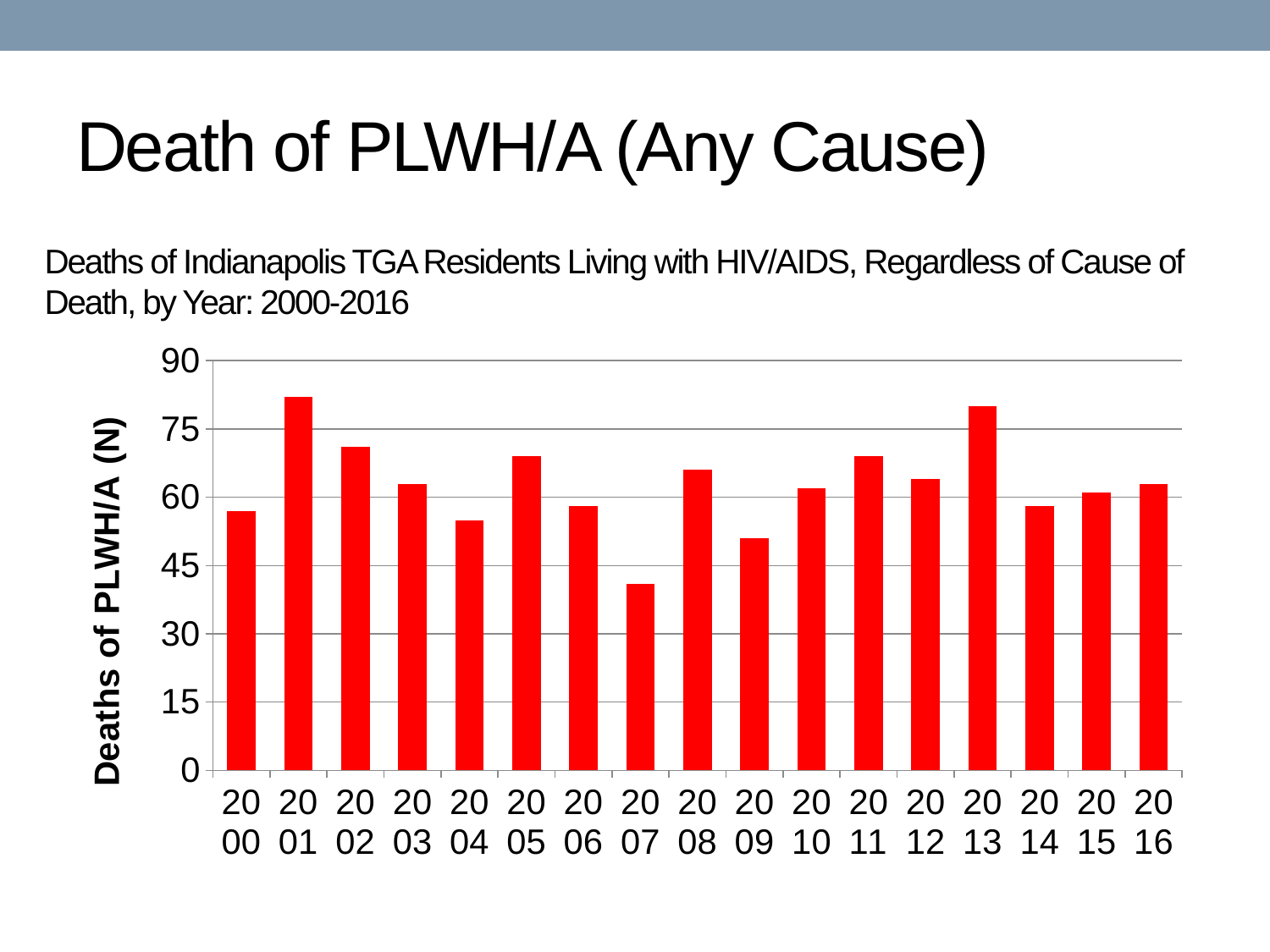
Is the value for 2002 greater or less than 60? greater Is the value for 2013 greater or less than 75? greater What kind of chart is shown on the slide? bar chart Which year has the lowest number of deaths of PLWH/A? 2007 Which year has the larger value, 2001 or 2007? 2001 How many years are plotted on the x axis of the chart? 17 Is the value for 2001 greater or less than 75? greater What colour are the bars in the chart? red Which year has the larger value, 2009 or 2013? 2013 What is the title of the y axis of the chart? Deaths of PLWH/A (N)